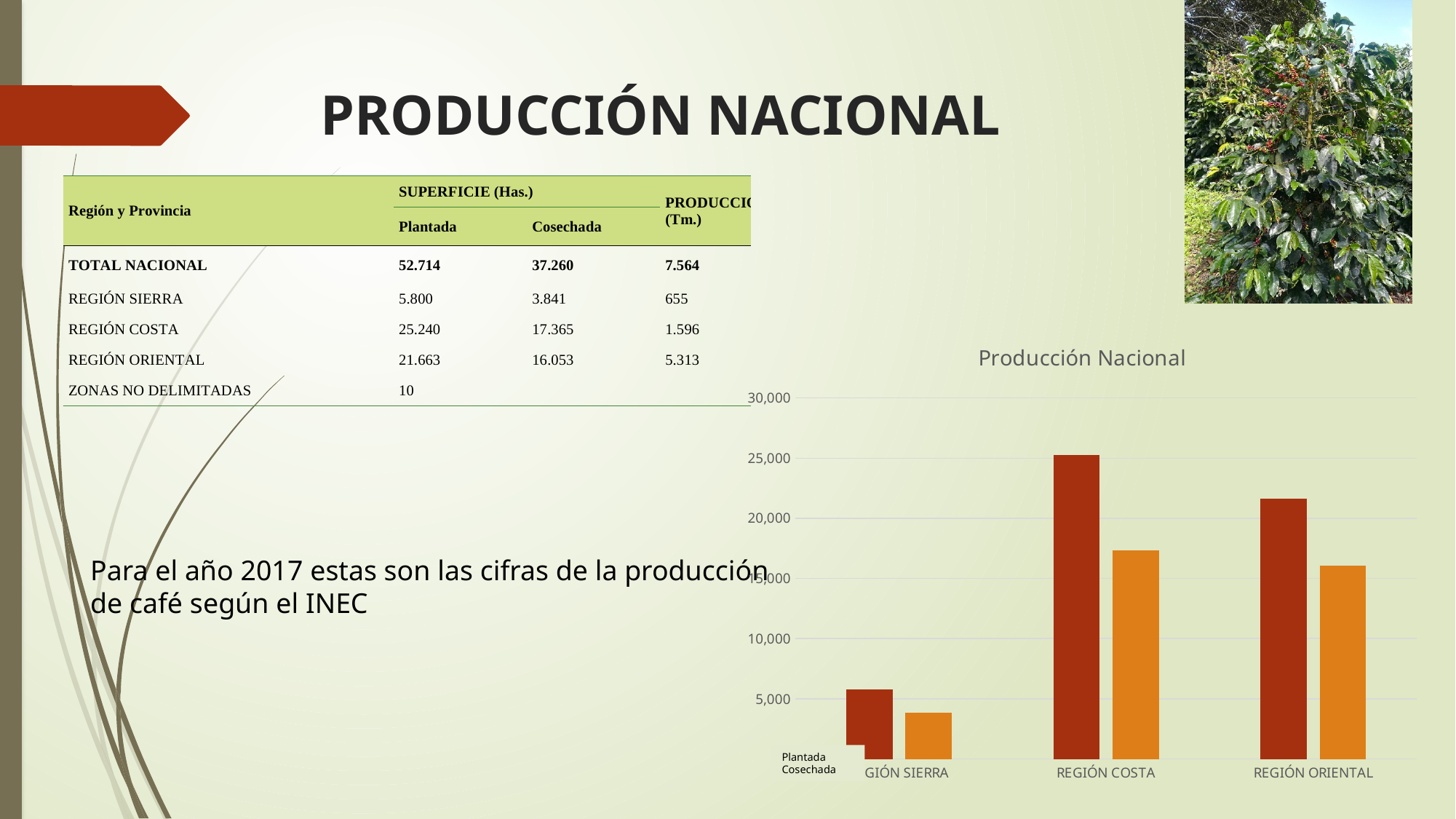
Is the Cosechada value for REGIÓN COSTA greater or less than 15,000? greater Which region has the larger Plantada bar: REGIÓN COSTA or REGIÓN ORIENTAL? REGIÓN COSTA Is the Plantada value for REGIÓN ORIENTAL greater or less than 20,000? greater Is the Cosechada value for REGIÓN SIERRA greater or less than 5,000? less Which region has the highest Plantada bar in the chart? REGIÓN COSTA What is the title of the chart on the slide? Producción Nacional How many region categories are plotted on the x axis of the chart? 3 What kind of chart is shown on the slide? bar chart For REGIÓN COSTA, which is larger: the Plantada bar or the Cosechada bar? Plantada Which region has the lowest Cosechada bar in the chart? REGIÓN SIERRA How many series does the chart's legend list? 2 Which colour represents the Cosechada series in the chart? orange